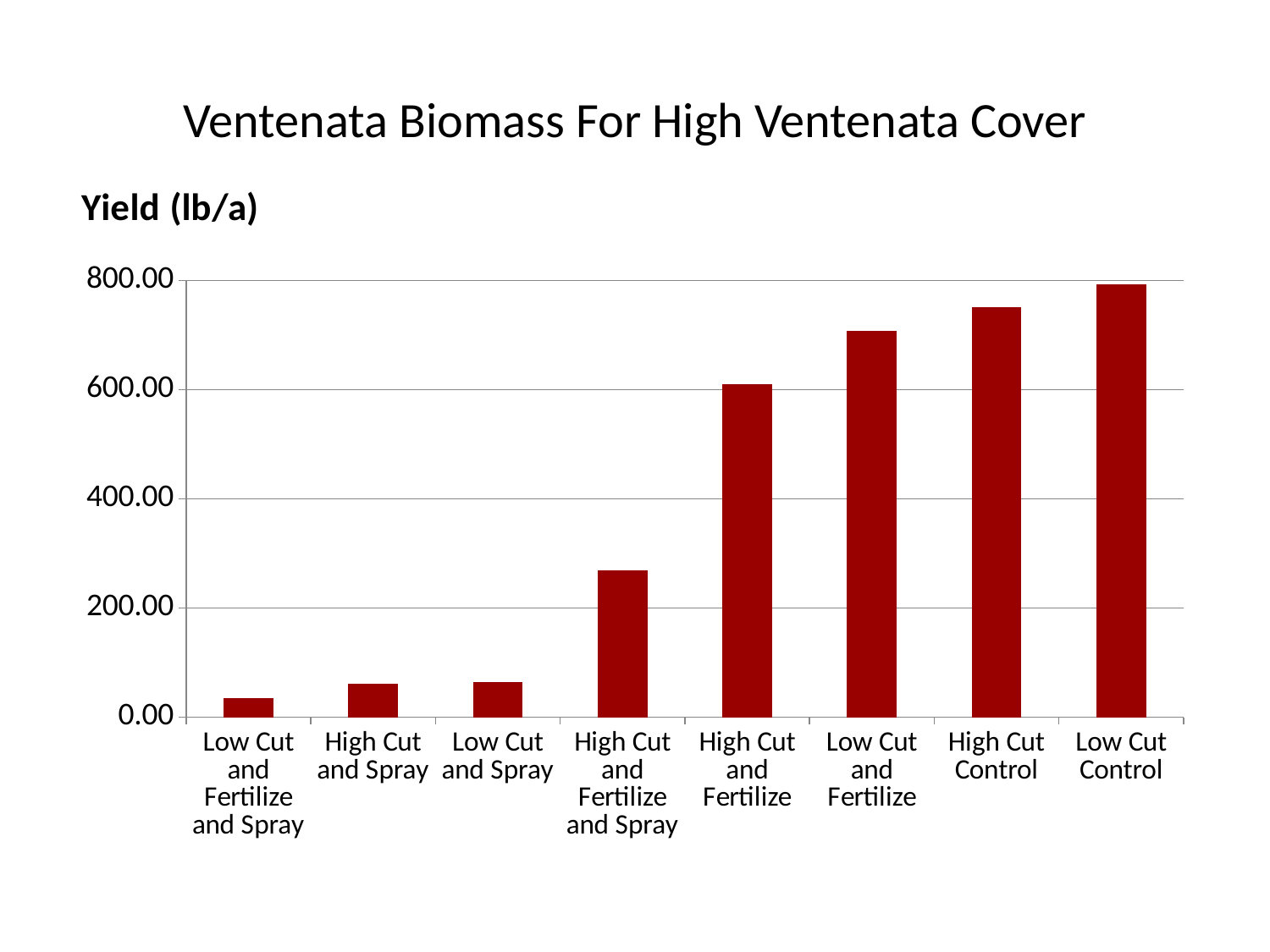
Is the value for High Cut and Fertilize greater or less than 600.00? greater Which is larger, the value for High Cut and Fertilize and Spray or the value for Low Cut and Spray? High Cut and Fertilize and Spray Which treatment has the highest Ventenata biomass yield? Low Cut Control What kind of chart is shown on the slide? Bar chart Which treatment has the lowest Ventenata biomass yield? Low Cut and Fertilize and Spray What is the title of the chart? Ventenata Biomass For High Ventenata Cover Is the value for Low Cut Control greater or less than 800.00? less How many treatment categories are plotted on the chart? 8 Is the value for High Cut and Fertilize and Spray greater or less than 400.00? less Which is larger, the value for High Cut Control or the value for High Cut and Fertilize? High Cut Control Do the bar values generally rise or fall from left to right across the x axis? Rise